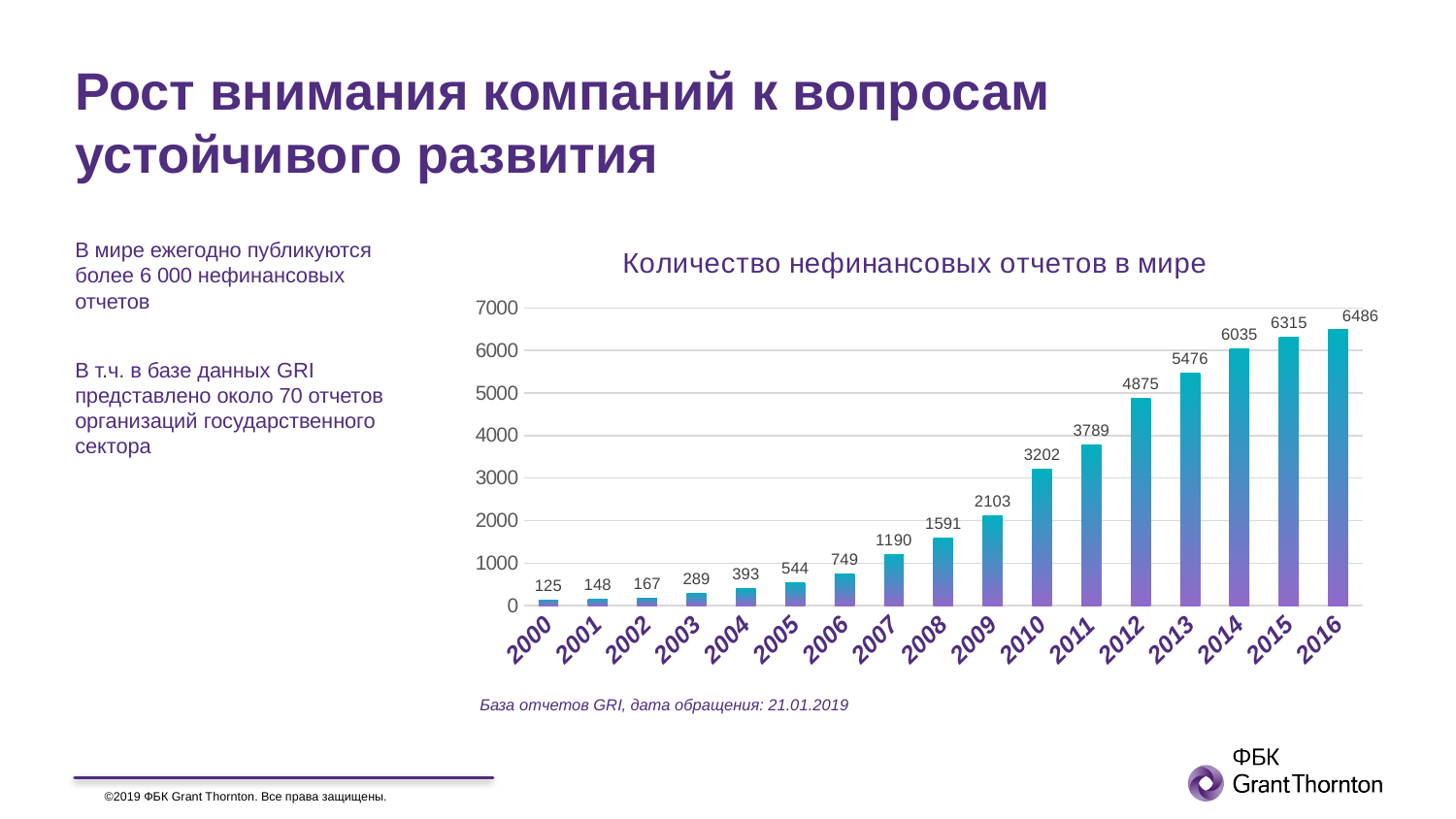
What is the value for 2016? 6486 What is the difference between the values for 2016 and 2015? 171 What is the value for 2010? 3202 What kind of chart is shown on the slide? bar chart Which year has the highest value? 2016 Which year has the lowest value? 2000 How many years are shown on the x axis? 17 What is the difference between the values for 2012 and 2011? 1086 What is the value for 2005? 544 Which is larger, the value for 2008 or the value for 2009? 2009 Do the values rise or fall from 2000 to 2016? rise Is the value for 2013 greater or less than 5000? greater